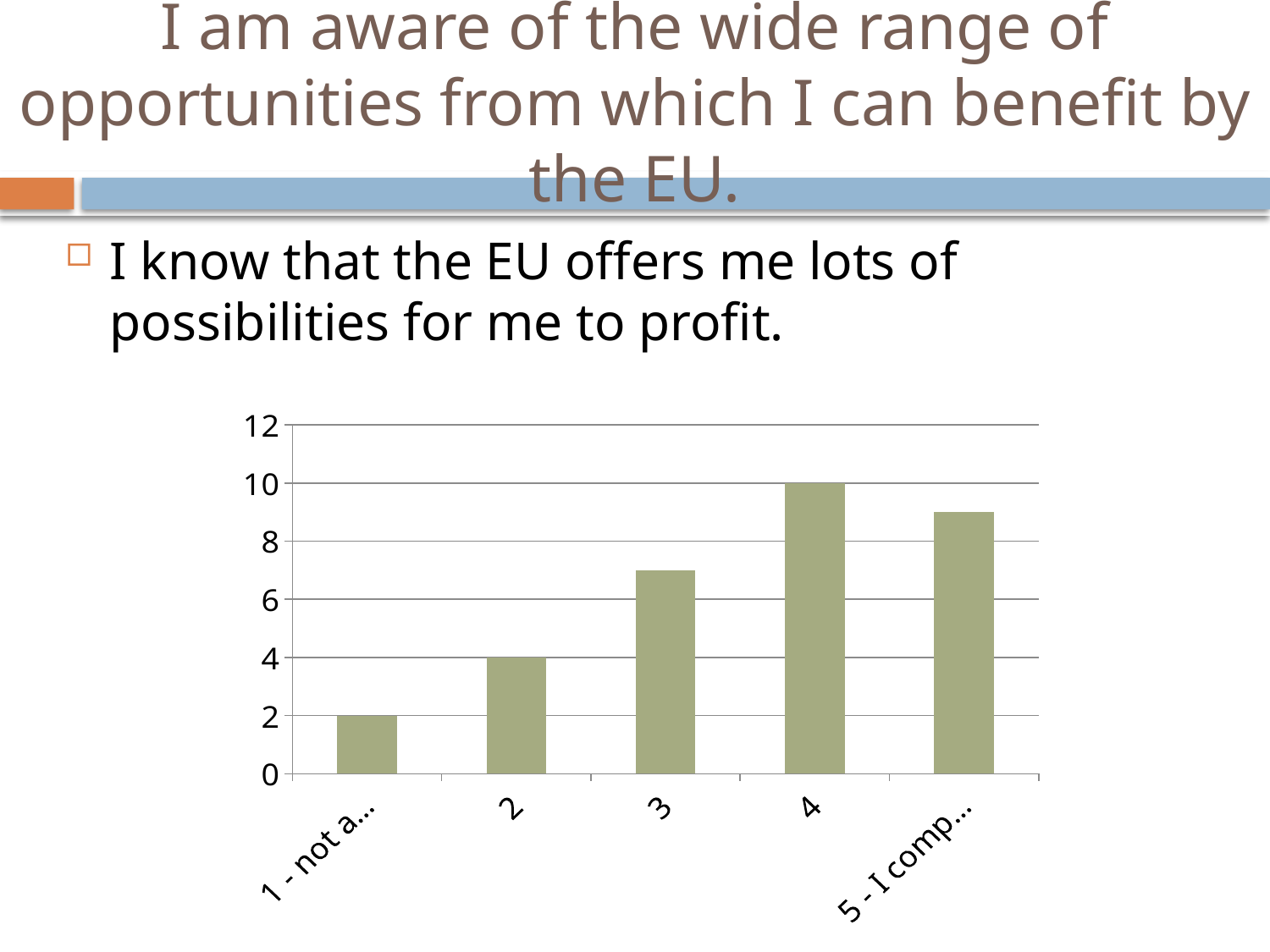
Is the value for category 3 greater or less than 6? greater Which category has the highest value? 4 Which category has the lowest value? 1 - not a... Which has a larger value, category 3 or category "5 - I comp..."? 5 - I comp... What is the value for the first category, "1 - not a..."? 2 How many categories are shown on the x axis? 5 Is the value for category "5 - I comp..." greater or less than 10? less What is the value for category 4? 10 What is the difference between the value for category 4 and the value for category 2? 6 What is the value for category 2? 4 What kind of chart is shown on the slide? bar chart Do the values rise or fall from category 1 to category 4? rise